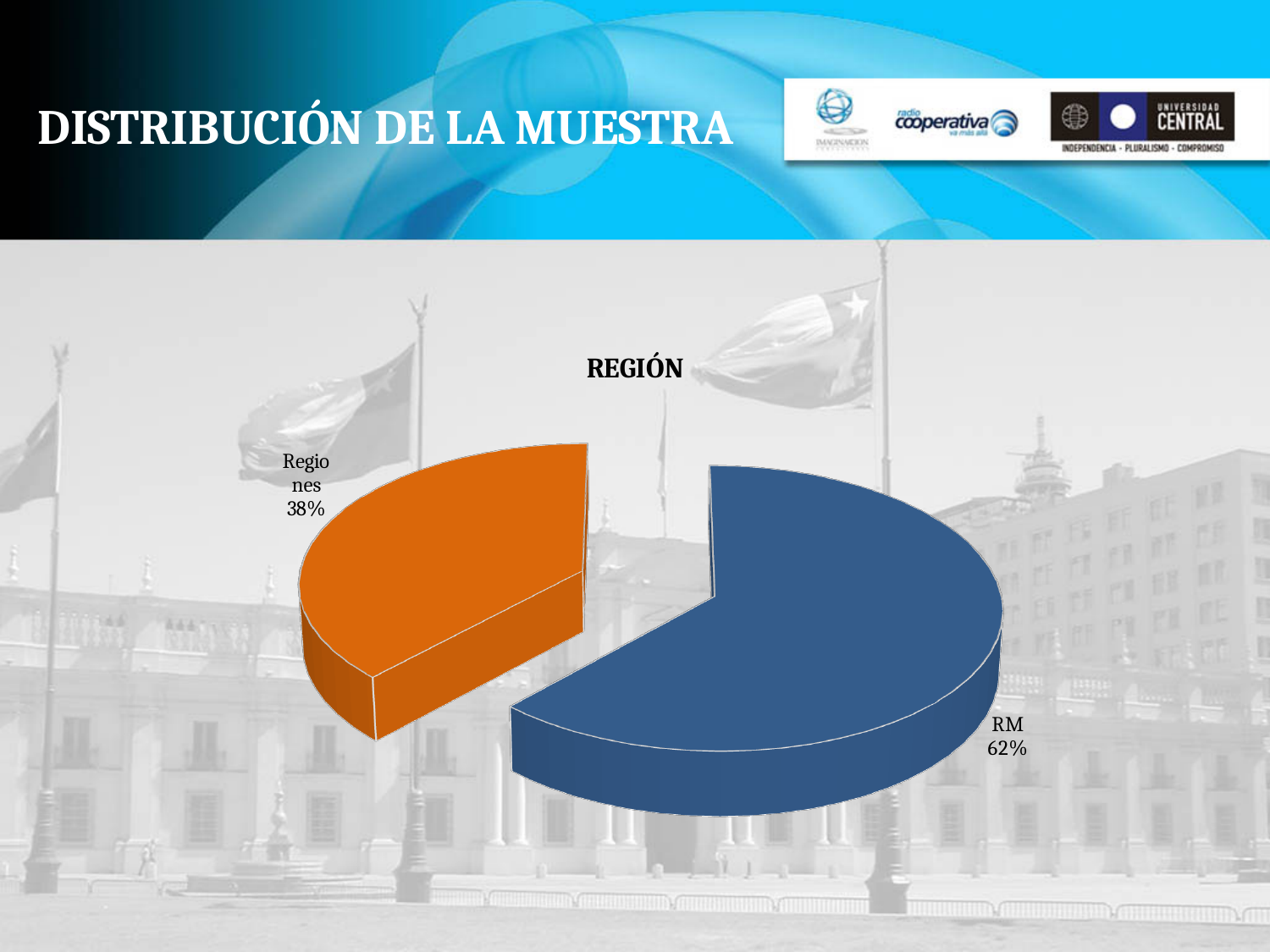
Which category has the largest share of the pie? RM What colour is the RM slice? blue What is the title of the chart? REGIÓN What share of the pie does the Regiones slice represent? 38% Which is larger, the share for RM or the share for Regiones? RM What percentage of the sample is from RM? 62% How many slices does the pie chart have? 2 What percentage of the sample is from Regiones? 38% What kind of chart is shown on the slide? pie chart What is the difference in percentage points between RM and Regiones? 24 Which category has the smallest share of the pie? Regiones